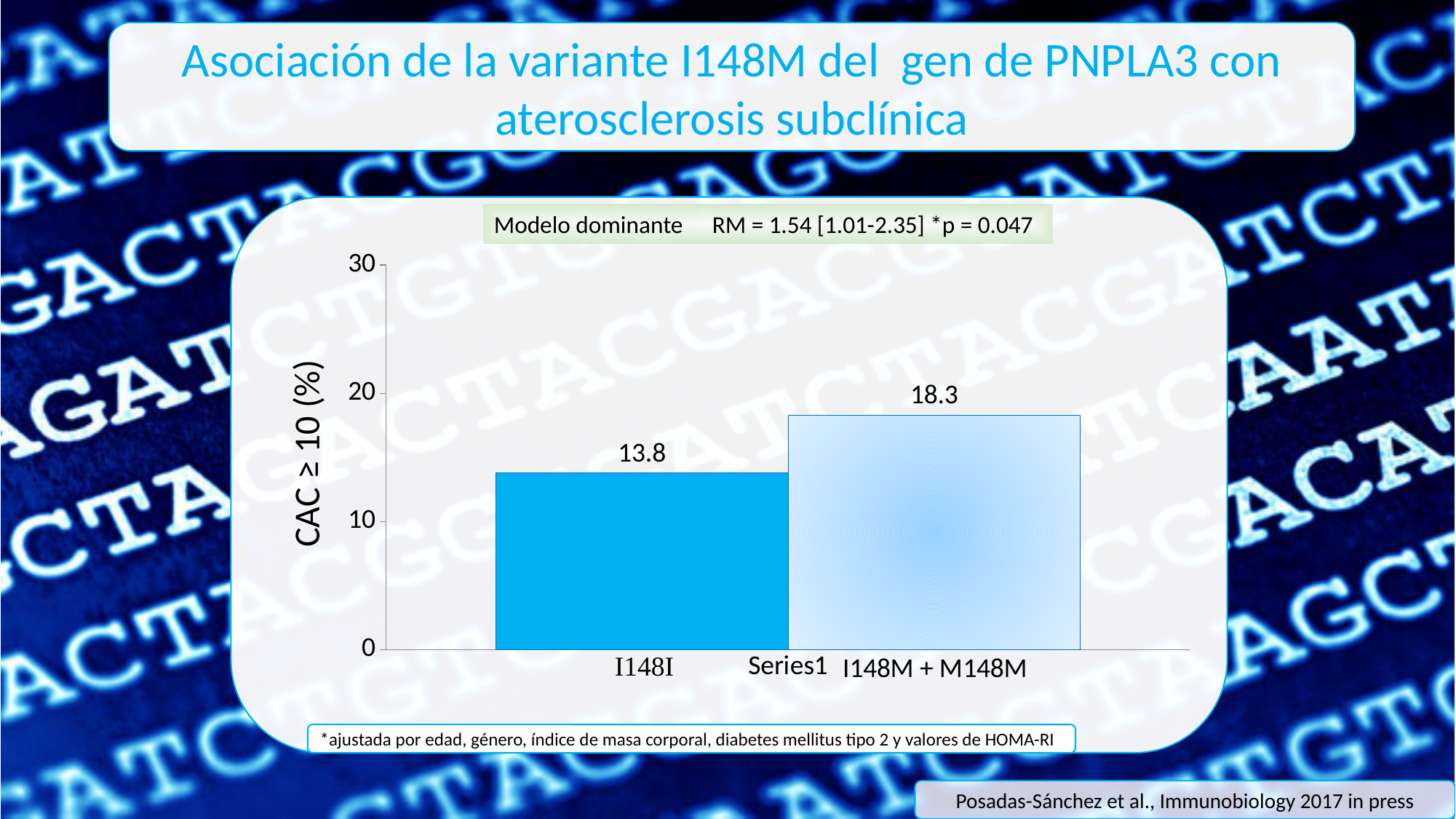
Which category has the highest value? I148M + M148M How many categories are shown on the x axis? 2 What is the maximum value shown on the y axis? 30 What kind of chart is shown on the slide? bar chart Which is larger, the value for I148I or the value for I148M + M148M? I148M + M148M What is the label of the y axis? CAC ≥ 10 (%) Is the value for I148I greater or less than 10? greater Is the value for I148M + M148M greater or less than 20? less What is the difference between the values for I148M + M148M and I148I? 4.5 What is the value for I148M + M148M? 18.3 Which category has the lowest value? I148I What is the value for I148I? 13.8